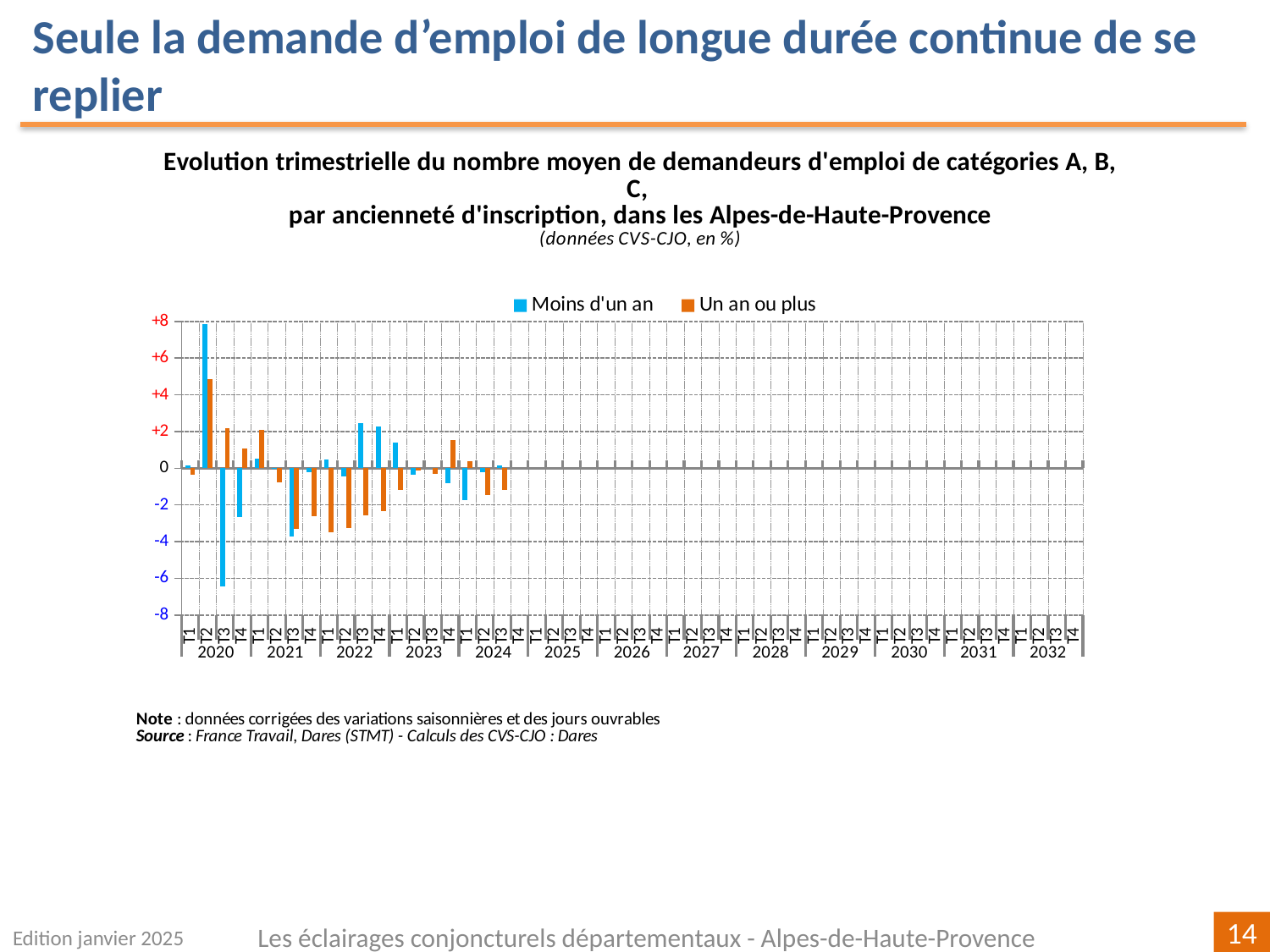
How many years are labelled along the x axis? 13 In which quarter is the value for 'Moins d'un an' the highest? T2 2020 In which quarter is the value for 'Moins d'un an' the lowest? T3 2020 Is the value for 'Moins d'un an' in T2 2020 greater or less than +6? greater What are the two series named in the legend? Moins d'un an; Un an ou plus What kind of chart is shown on the slide? bar chart In T3 2020, which series has the larger value, 'Moins d'un an' or 'Un an ou plus'? Un an ou plus How many series does the legend list? 2 Is the value for 'Un an ou plus' in T2 2022 greater or less than -2? less In which quarter is the value for 'Un an ou plus' the highest? T2 2020 Is the value for 'Moins d'un an' in T3 2020 greater or less than -6? less Which colour represents the series 'Un an ou plus'? orange